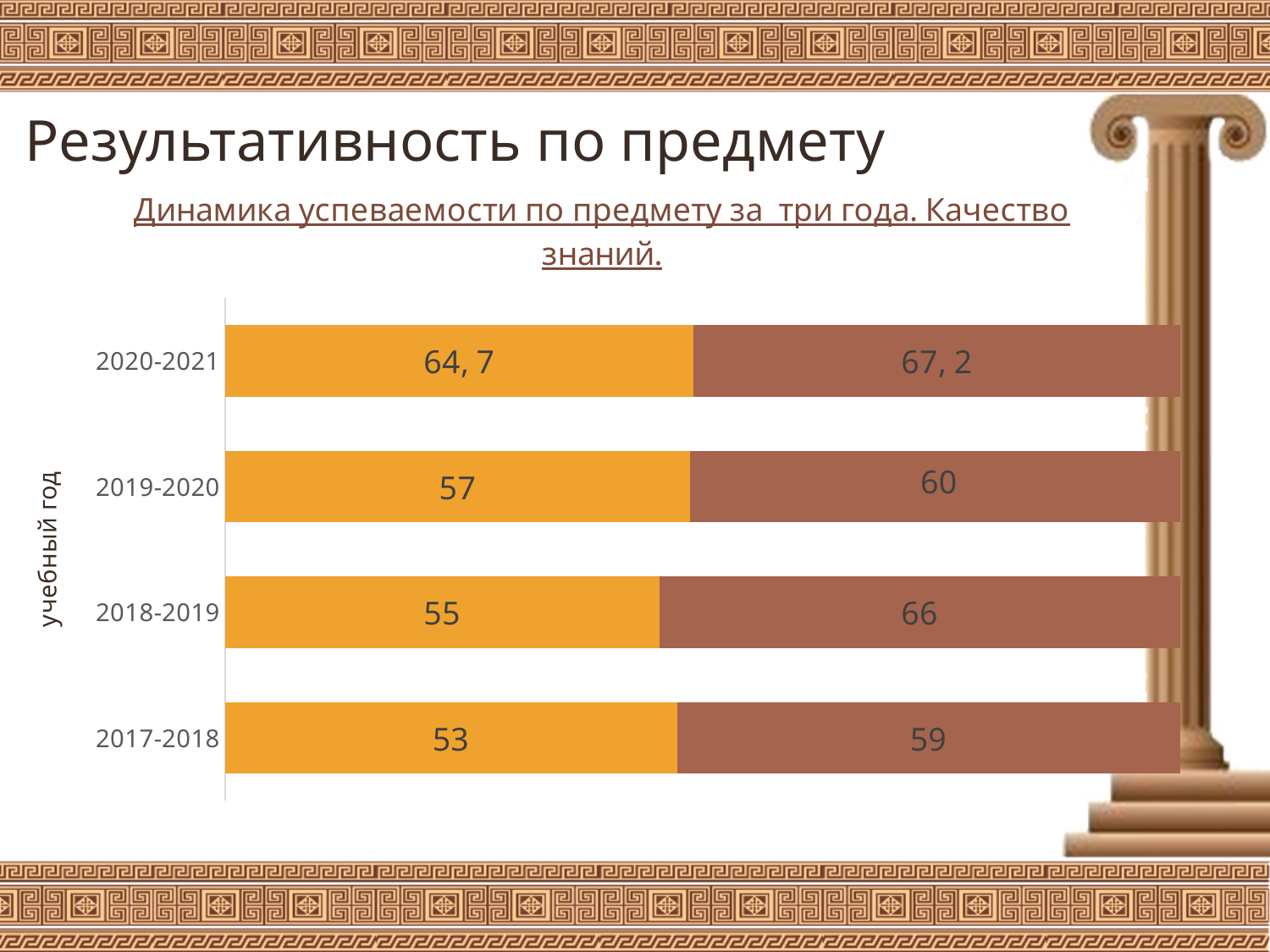
What is the value of the orange segment for 2020-2021? 64, 7 What is the value of the brown segment for 2019-2020? 60 Which academic year has the highest value in the orange series? 2020-2021 How many academic years (categories) are shown in the chart? 4 What is the label of the vertical axis? учебный год What type of chart is shown on the slide? bar chart Which is larger: the orange segment for 2019-2020 or the orange segment for 2018-2019? 2019-2020 What is the value of the orange segment for 2017-2018? 53 What is the value of the brown segment for 2018-2019? 66 What is the difference between the brown segment values for 2018-2019 and 2017-2018? 7 Which academic year has the lowest value in the brown series? 2017-2018 What is the total of the stacked bar for 2018-2019? 121